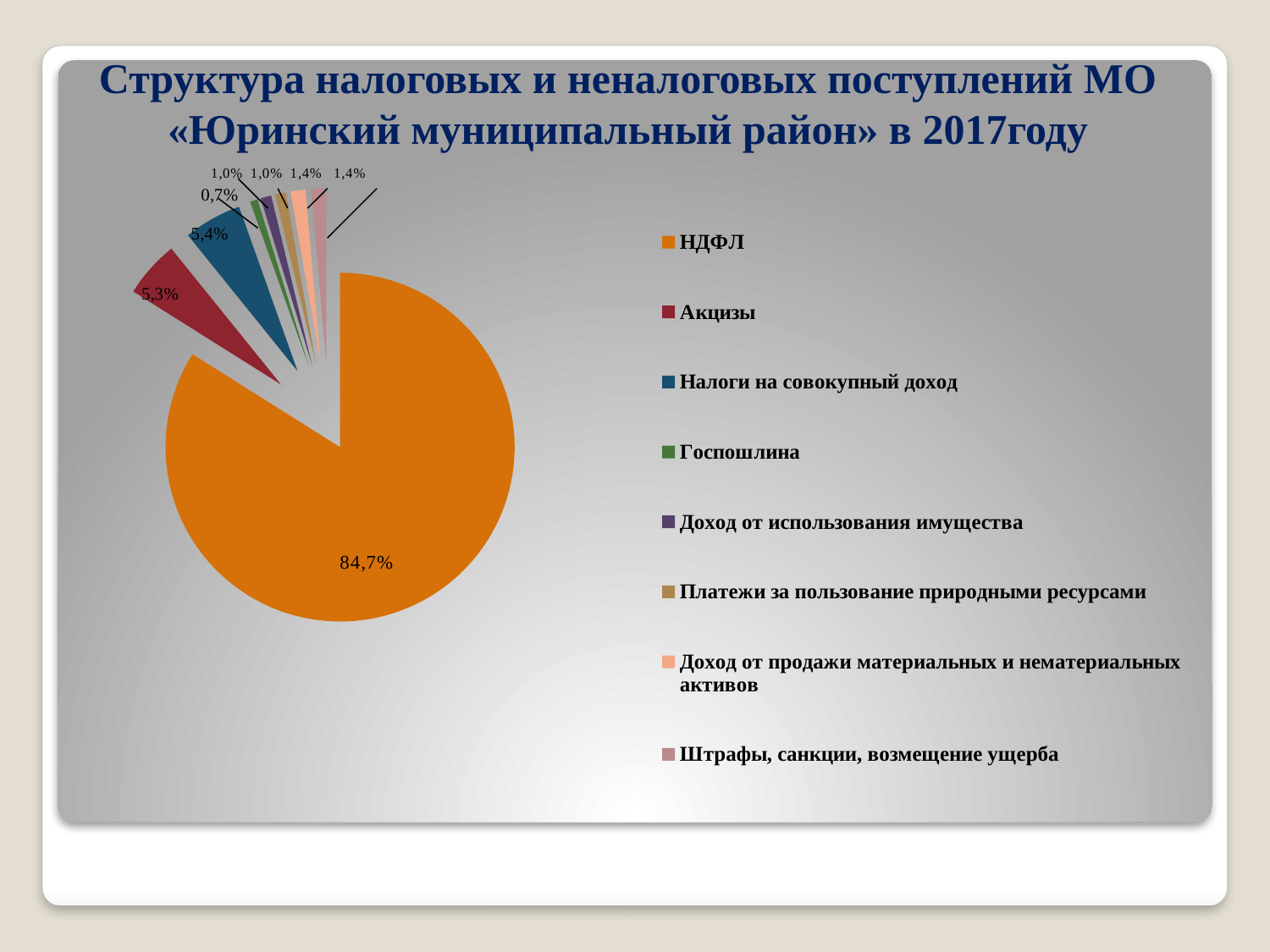
What is the value shown for Акцизы? 5,3% What kind of chart is shown on the slide? Pie chart Which is larger, the slice for НДФЛ or the slice for Акцизы? НДФЛ What share of the pie does НДФЛ account for? 84,7% How many entries does the legend list? 8 What is the value shown for Госпошлина? 0,7% Which category has the largest slice of the pie? НДФЛ What is the value shown for Налоги на совокупный доход? 5,4% What colour is the slice for НДФЛ? Orange Which category has the smallest slice of the pie? Госпошлина What is the difference between the share of НДФЛ and the share of Акцизы? 79,4% How many slices does the pie chart have? 8